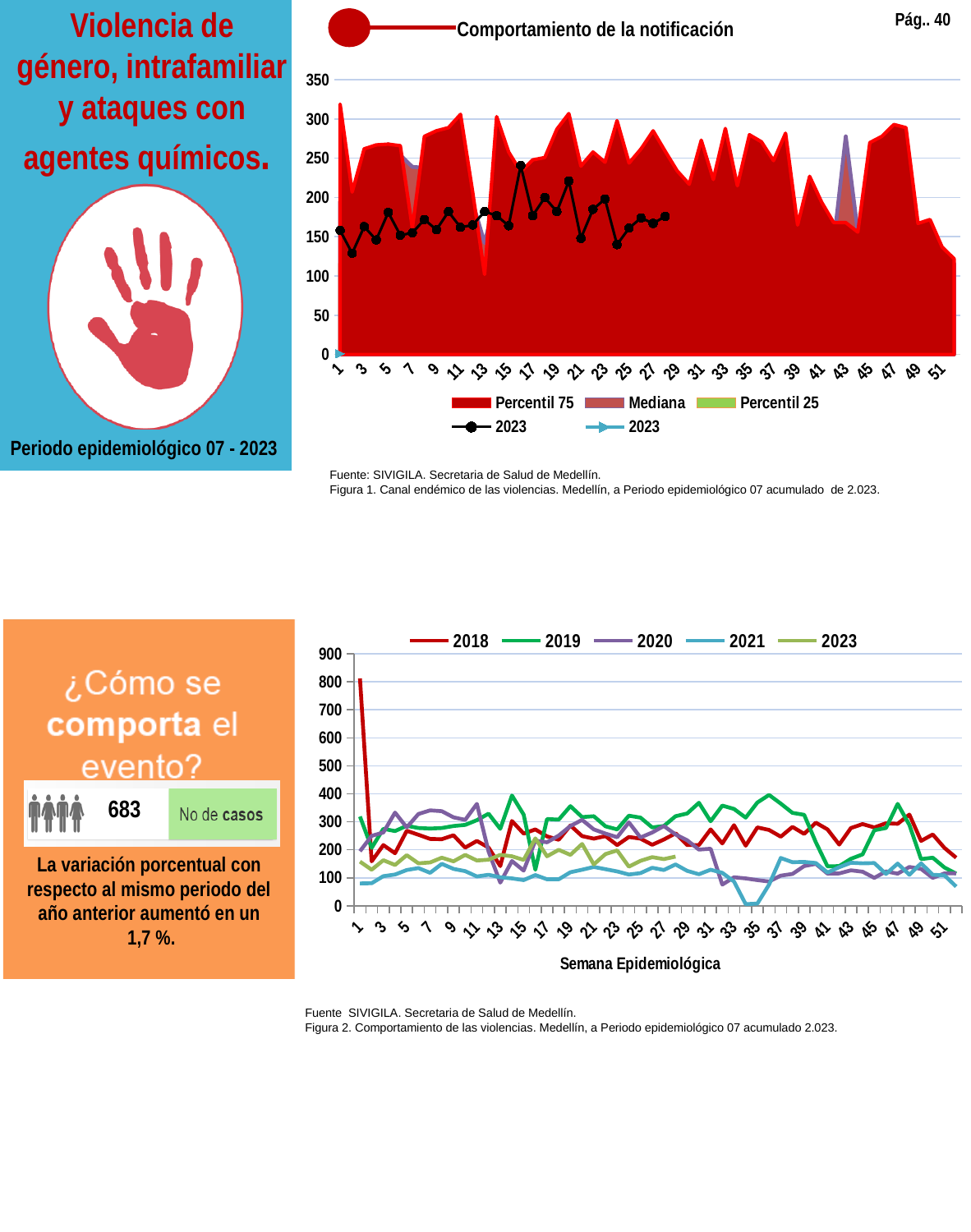
In the bottom chart (Figura 2), what is the label of the horizontal axis? Semana Epidemiológica In the top chart 'Comportamiento de la notificación', how many series does the legend list? 5 In the top chart 'Comportamiento de la notificación', what is the highest value shown on the vertical axis? 350 In the bottom chart (Figura 2), is the value of the 2021 series at week 35 greater or less than 100? less What kind of chart is the bottom chart (Figura 2, Comportamiento de las violencias)? line chart In the bottom chart (Figura 2), does the 2018 series rise or fall from week 1 to week 2? fall In the top chart 'Comportamiento de la notificación', is the value of the 2023 line at week 16 greater or less than 200? greater What is the title of the top chart? Comportamiento de la notificación In the top chart 'Comportamiento de la notificación', is the value of the 2023 line at week 2 greater or less than 150? less In the bottom chart (Figura 2), how many series does the legend list? 5